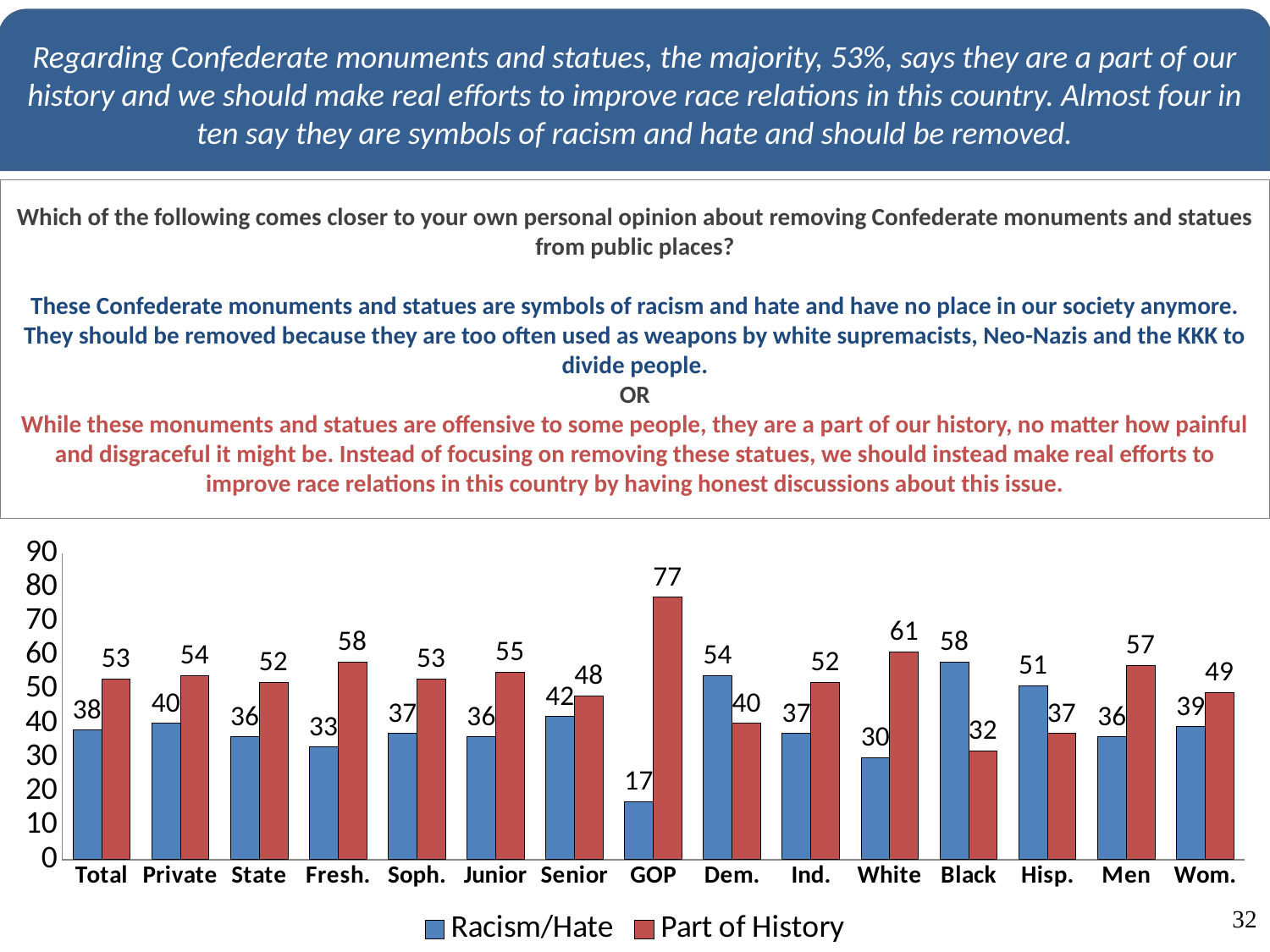
How many categories are shown on the x axis? 15 Which category has the lowest Part of History value? Black How many series does the legend list? 2 What is the Part of History value for GOP? 77 Which category has the lowest Racism/Hate value? GOP Which category has the highest Part of History value? GOP What is the difference between the Part of History and Racism/Hate values for White? 31 What colour are the Part of History bars? Red What kind of chart is shown on the slide? Bar chart For Dem., which is larger: Racism/Hate or Part of History? Racism/Hate What is the Racism/Hate value for Total? 38 What is the Racism/Hate value for Black? 58